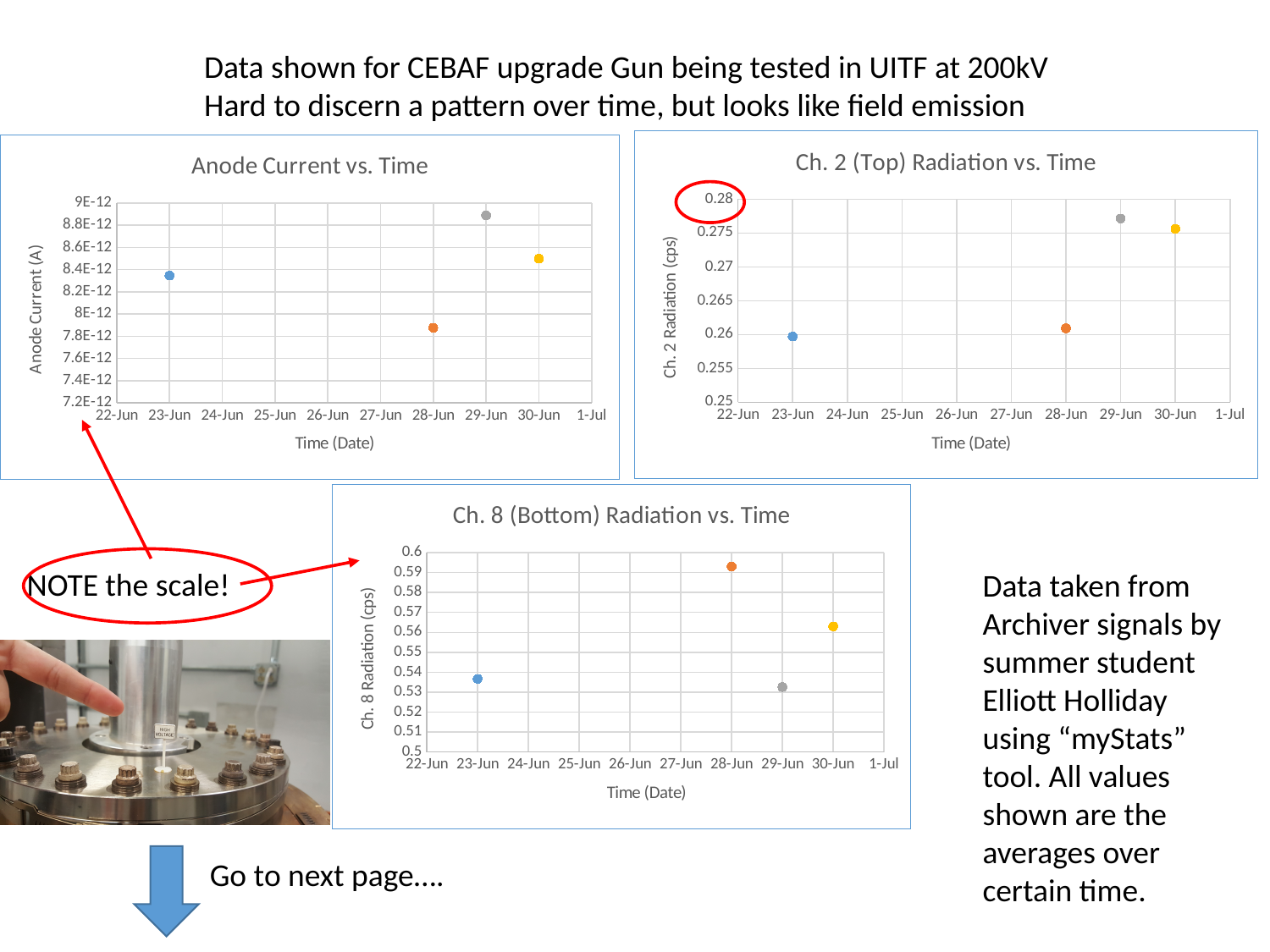
What is the y-axis label of the "Ch. 8 (Bottom) Radiation vs. Time" chart? Ch. 8 Radiation (cps) In the "Anode Current vs. Time" chart, on which date is the anode current lowest? 28-Jun What kind of chart is "Anode Current vs. Time"? scatter chart In the "Ch. 8 (Bottom) Radiation vs. Time" chart, which is larger, the value for 30-Jun or the value for 29-Jun? 30-Jun In the "Ch. 2 (Top) Radiation vs. Time" chart, is the value for 23-Jun greater or less than 0.265? less In the "Anode Current vs. Time" chart, on which date is the anode current highest? 29-Jun In the "Anode Current vs. Time" chart, how many data points are plotted? 4 In the "Anode Current vs. Time" chart, is the value for 28-Jun greater or less than 8E-12? less In the "Ch. 2 (Top) Radiation vs. Time" chart, on which date is the radiation highest? 29-Jun In the "Ch. 8 (Bottom) Radiation vs. Time" chart, is the value for 28-Jun greater or less than 0.58? greater In the "Ch. 8 (Bottom) Radiation vs. Time" chart, on which date is the radiation highest? 28-Jun In the "Ch. 2 (Top) Radiation vs. Time" chart, which is larger, the value for 29-Jun or the value for 28-Jun? 29-Jun